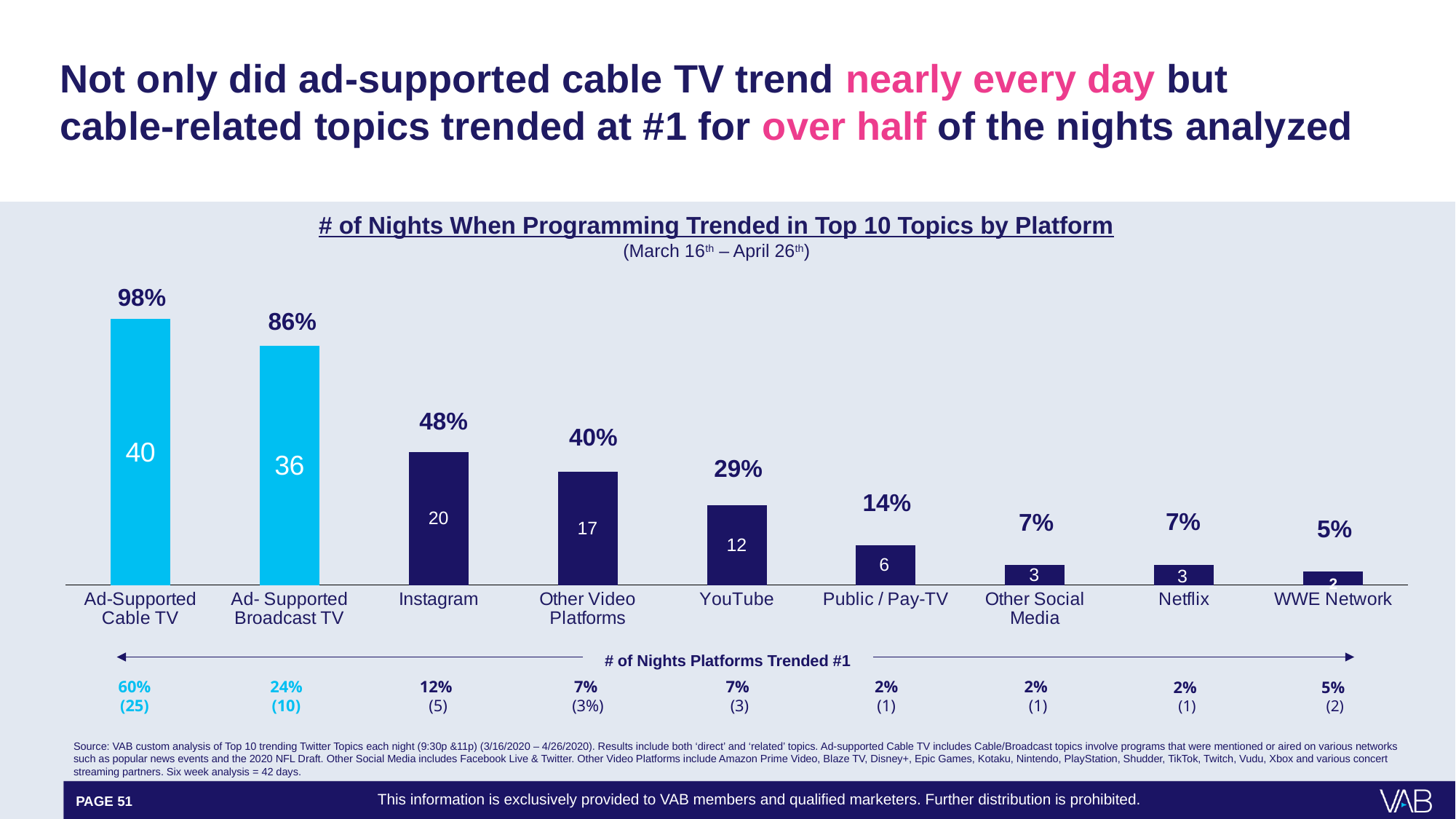
What is the difference in number of nights between Ad-Supported Cable TV and Ad- Supported Broadcast TV? 4 What is the title of the chart? # of Nights When Programming Trended in Top 10 Topics by Platform Which platform has the highest number of nights in the chart? Ad-Supported Cable TV Which platform has the lowest number of nights in the chart? WWE Network What kind of chart is shown on the slide? bar chart What is the number of nights shown inside the bar for YouTube? 12 What is the number of nights shown inside the bar for Ad-Supported Cable TV? 40 What percentage is shown above the bar for Instagram? 48% What percentage is shown above the bar for Public / Pay-TV? 14% Do the bar values rise or fall from left to right across the chart? fall How many platforms are shown on the x axis of the chart? 9 Which has more nights in the chart, Instagram or Other Video Platforms? Instagram